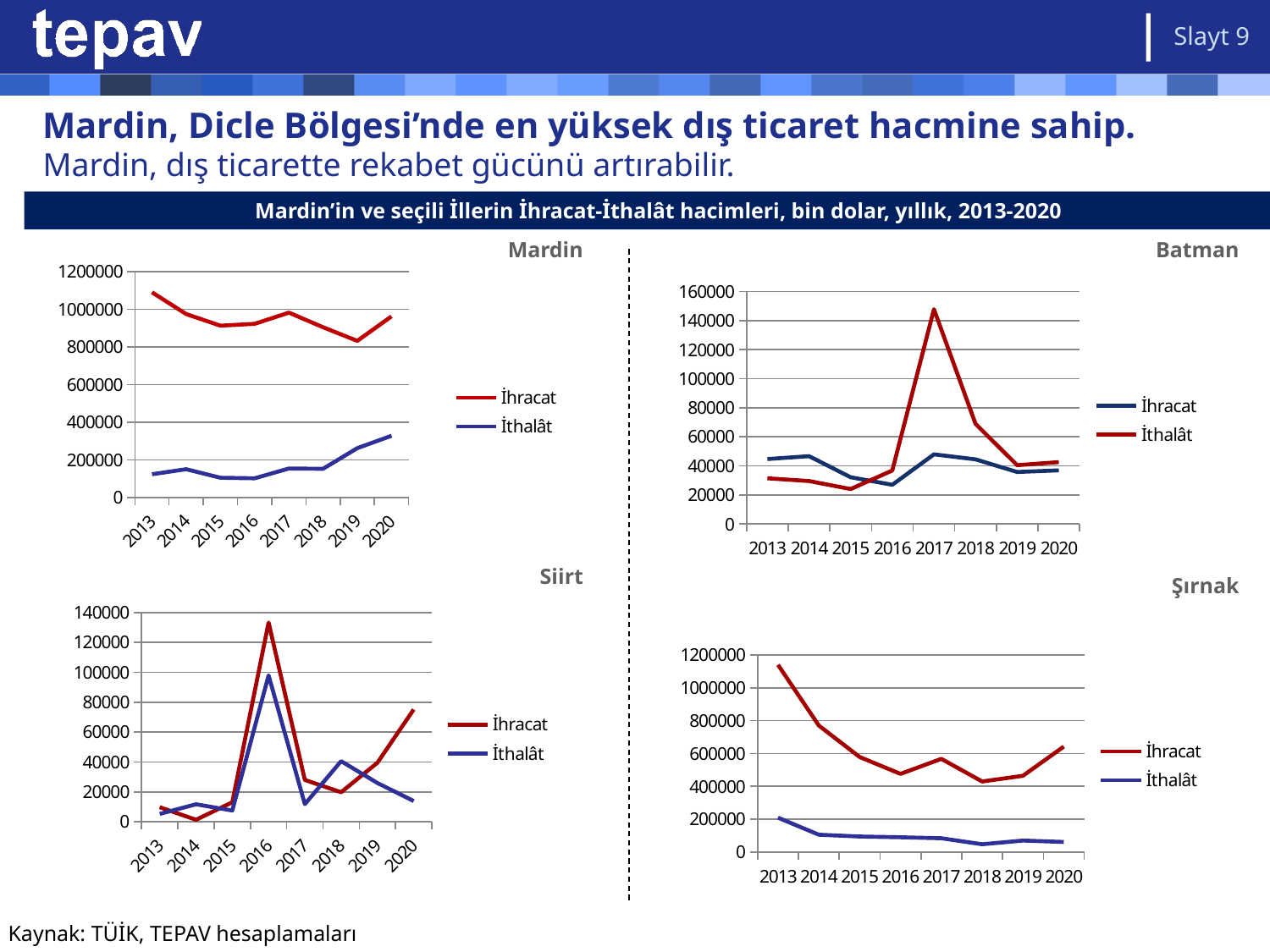
In the Mardin chart, is the İhracat value for 2013 greater or less than 1000000? greater In the Batman chart, which year has the highest İthalât value? 2017 In the Mardin chart, which year has the highest İthalât value? 2020 How many series does the legend of the Batman chart list? 2 In the Şırnak chart, which is larger in 2013, İhracat or İthalât? İhracat In the Mardin chart, which year has the lowest İhracat value? 2019 In the Şırnak chart, does the İthalât series generally rise or fall from 2013 to 2020? fall In the Batman chart, is the İthalât value for 2017 greater or less than 140000? greater In the Siirt chart, which year has the highest İhracat value? 2016 What kind of chart is the Mardin chart? line chart How many years are plotted on the x axis of the Siirt chart? 8